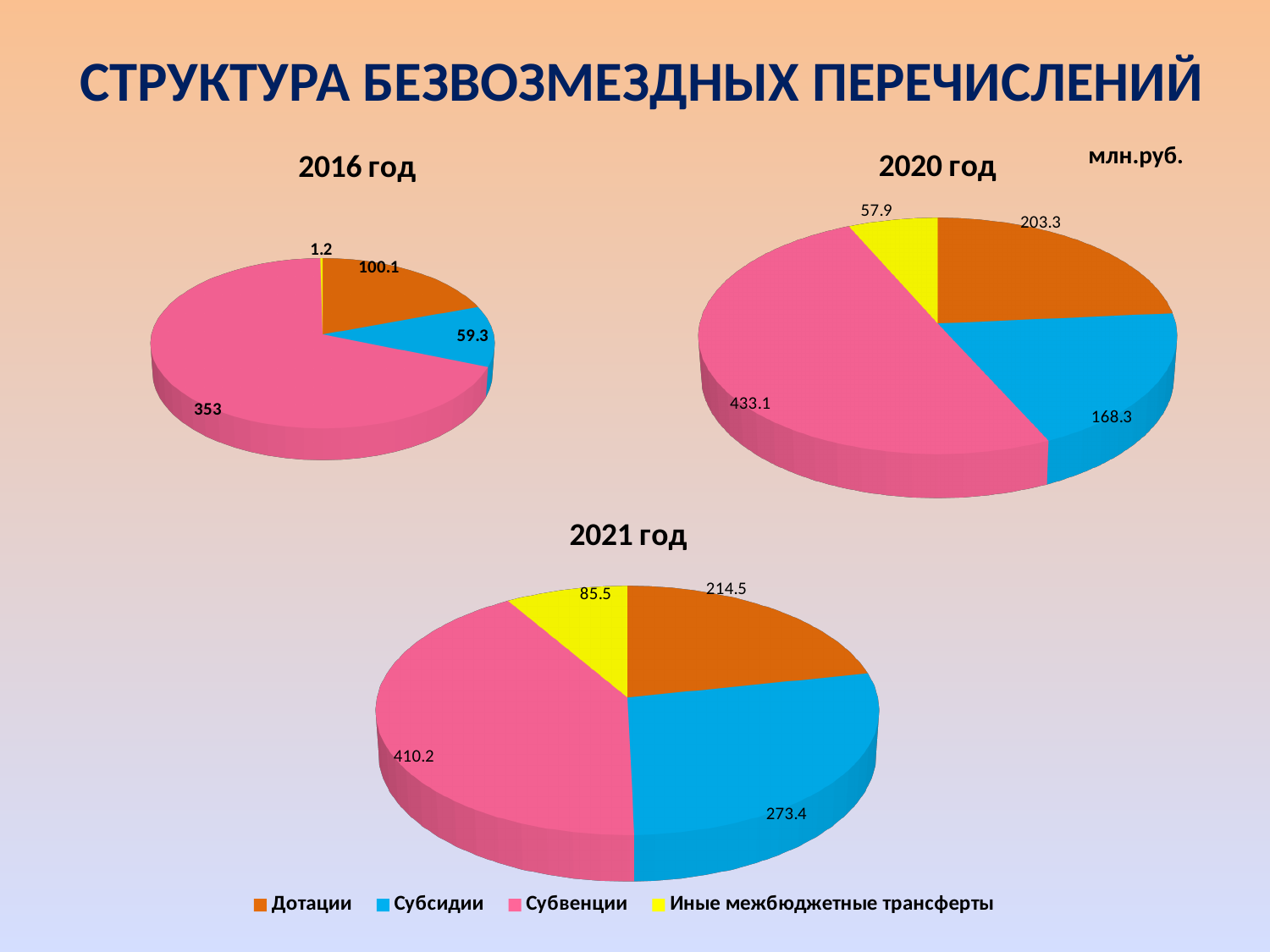
In the 2020 год pie chart, what is the value for Субсидии? 168.3 How many categories does the legend list? 4 What unit is shown on the slide for the chart values? млн.руб. In the 2021 год pie chart, which is larger: Субсидии or Дотации? Субсидии In the 2016 год pie chart, what is the value for Субвенции? 353 What kind of chart is the 2016 год chart? Pie chart In the 2016 год pie chart, which category has the smallest value? Иные межбюджетные трансферты What is the total of all slices in the 2021 год pie chart? 983.6 In the 2020 год pie chart, what is the difference between Субвенции and Дотации? 229.8 In the 2021 год pie chart, what is the value for Иные межбюджетные трансферты? 85.5 How many slices does the 2020 год pie chart have? 4 In the 2021 год pie chart, which category has the largest value? Субвенции